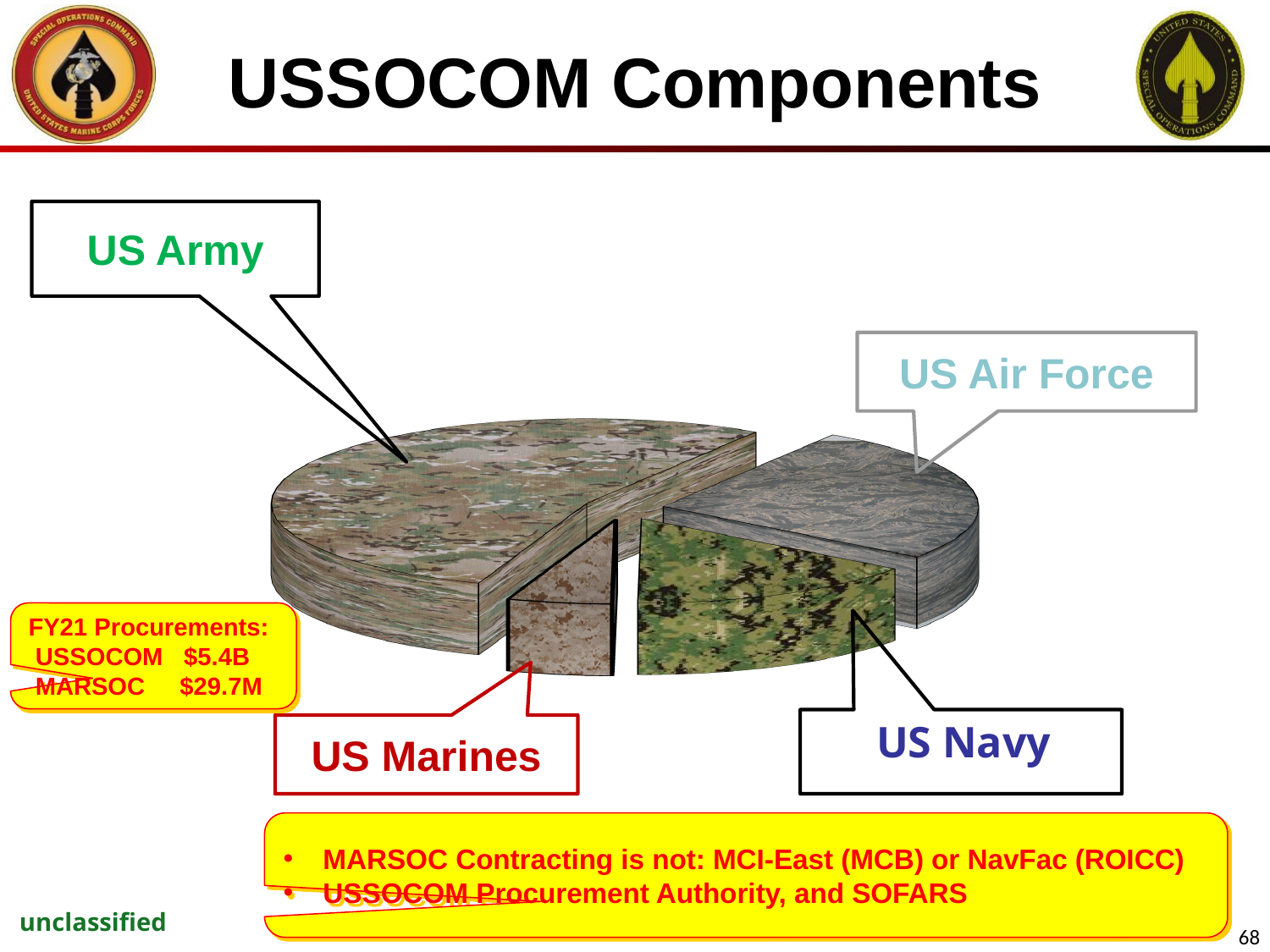
What kind of chart is shown on the slide? pie chart How many slices does the pie chart have? 4 Which component has the smallest slice of the pie chart? US Marines Which component has the largest slice of the pie chart? US Army Which slice is larger, US Navy or US Marines? US Navy Which four components are labelled on the pie chart? US Army, US Air Force, US Navy, US Marines Which slice is larger, US Army or US Navy? US Army What is the title of the slide containing the pie chart? USSOCOM Components Which slice is larger, US Air Force or US Marines? US Air Force